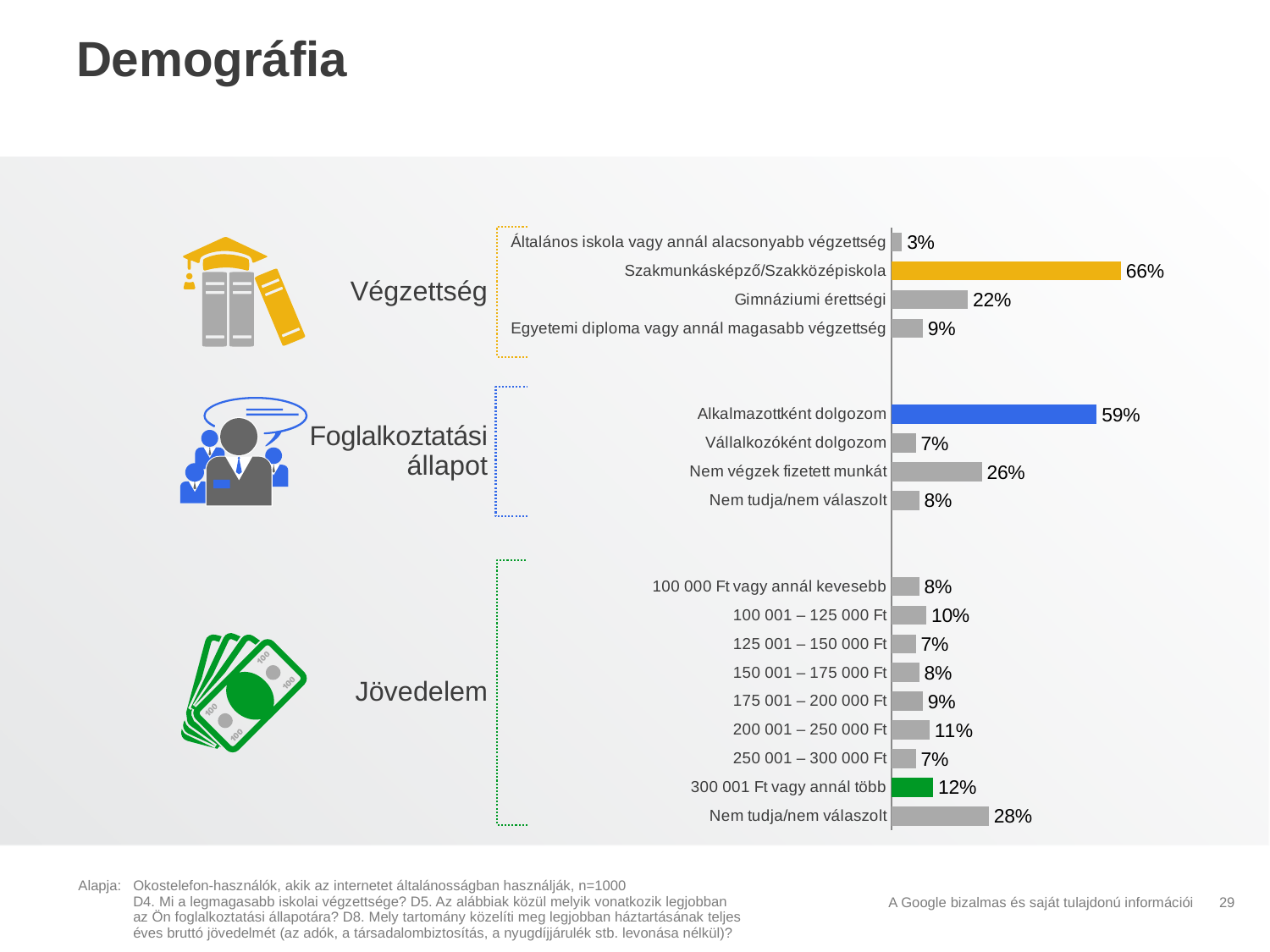
In the Jövedelem chart, which category has the highest value? Nem tudja/nem válaszolt In the Végzettség chart, what is the value for Szakmunkásképző/Szakközépiskola? 66% In the Végzettség chart, which category has the lowest value? Általános iskola vagy annál alacsonyabb végzettség In the Jövedelem chart, what is the difference between 200 001 – 250 000 Ft and 250 001 – 300 000 Ft? 4% In the Foglalkoztatási állapot chart, which category has the highest value? Alkalmazottként dolgozom In the Foglalkoztatási állapot chart, which is larger: Vállalkozóként dolgozom or Nem tudja/nem válaszolt? Nem tudja/nem válaszolt What type of chart is used in the Végzettség section? Bar chart How many categories are shown in the Jövedelem chart? 9 In the Végzettség chart, what is the difference between Gimnáziumi érettségi and Egyetemi diploma vagy annál magasabb végzettség? 13% In the Foglalkoztatási állapot chart, what is the value for Nem végzek fizetett munkát? 26% In the Jövedelem chart, what is the value for 300 001 Ft vagy annál több? 12% In the Jövedelem chart, which bar is coloured green? 300 001 Ft vagy annál több